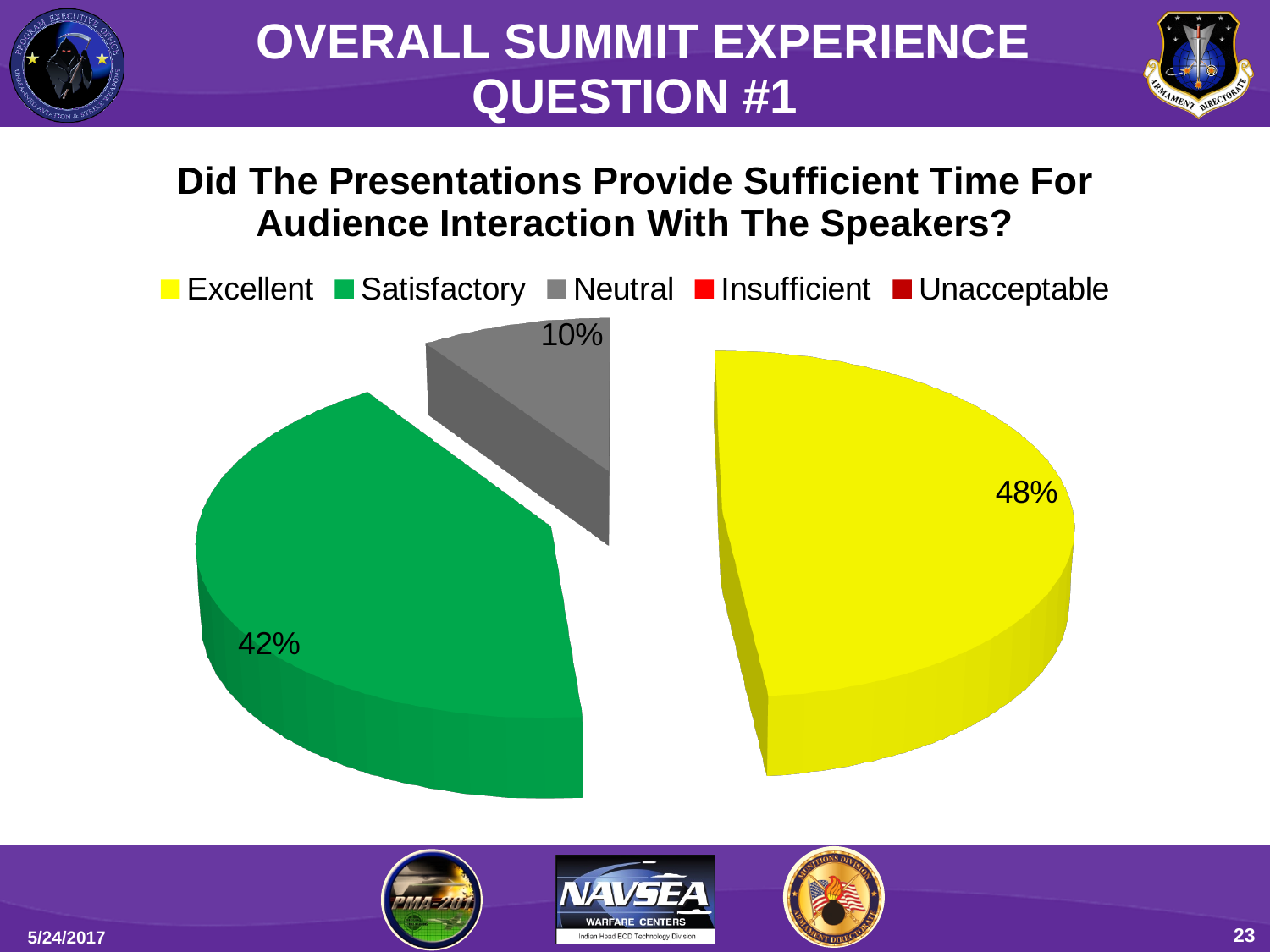
How many slices with data labels are shown in the pie? 3 What percentage of responses were Neutral? 10% What is the difference in percentage points between the Satisfactory and Neutral slices? 32 What colour represents the Satisfactory category in the chart? Green Which is larger, the Excellent slice or the Satisfactory slice? Excellent What percentage of responses were Satisfactory? 42% How many categories does the legend list? 5 Which response category with a visible slice has the smallest share of the pie? Neutral What type of chart is shown on the slide? Pie chart Which response category has the largest share of the pie? Excellent What is the difference in percentage points between the Excellent and Satisfactory slices? 6 What percentage of responses were Excellent? 48%